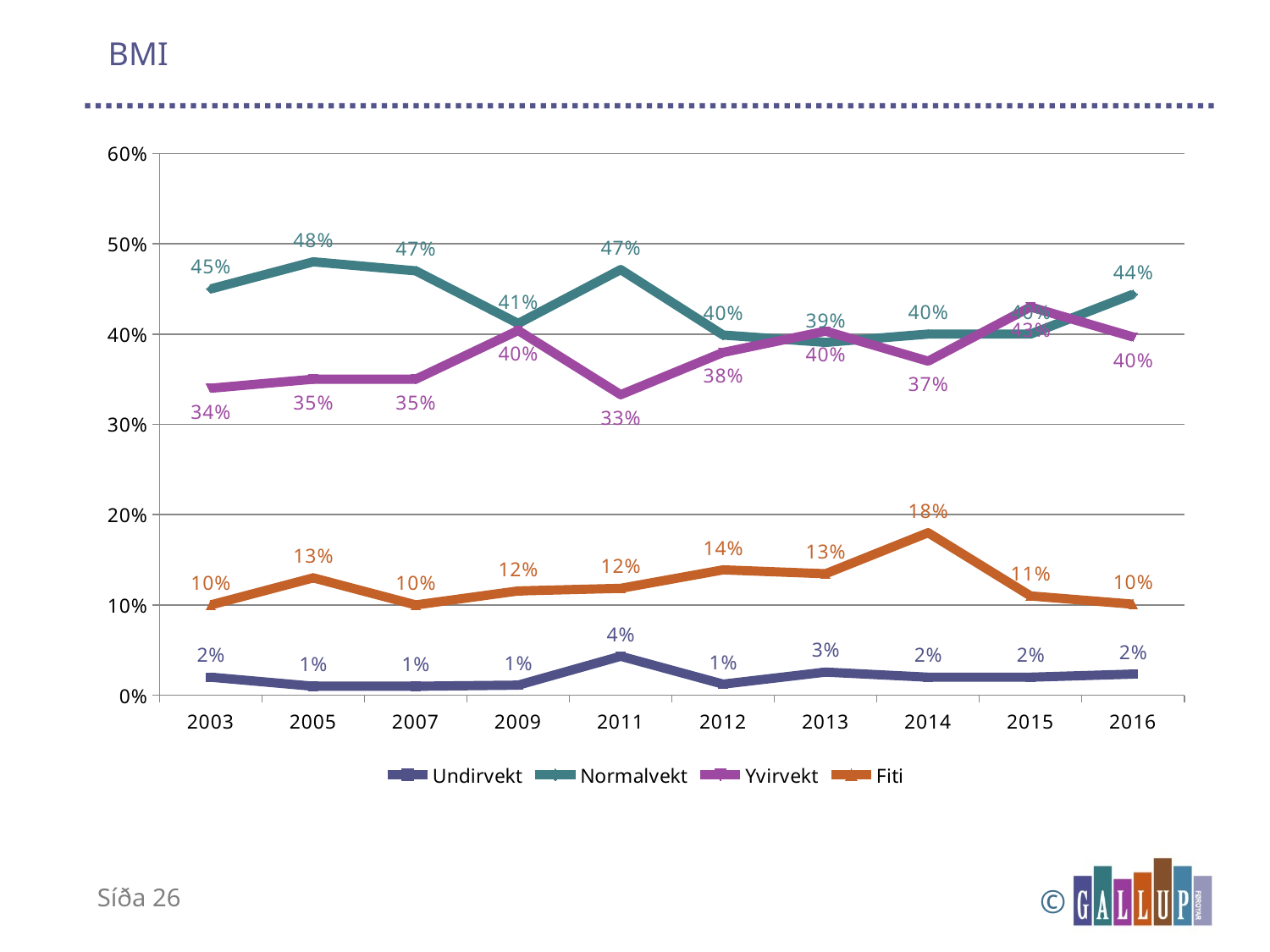
In 2011, which is larger: Normalvekt or Yvirvekt? Normalvekt How many series does the legend list? 4 What kind of chart is shown on the slide? line chart What is the value for Fiti in 2014? 18% How many years are shown on the x axis? 10 In which year is the Undirvekt series highest? 2011 What is the difference between the Fiti values in 2014 and 2015? 7 percentage points What is the title of the chart? BMI What is the value for Normalvekt in 2005? 48% In which year is the Yvirvekt series lowest? 2011 In which year is the Fiti series highest? 2014 What is the value for Yvirvekt in 2011? 33%